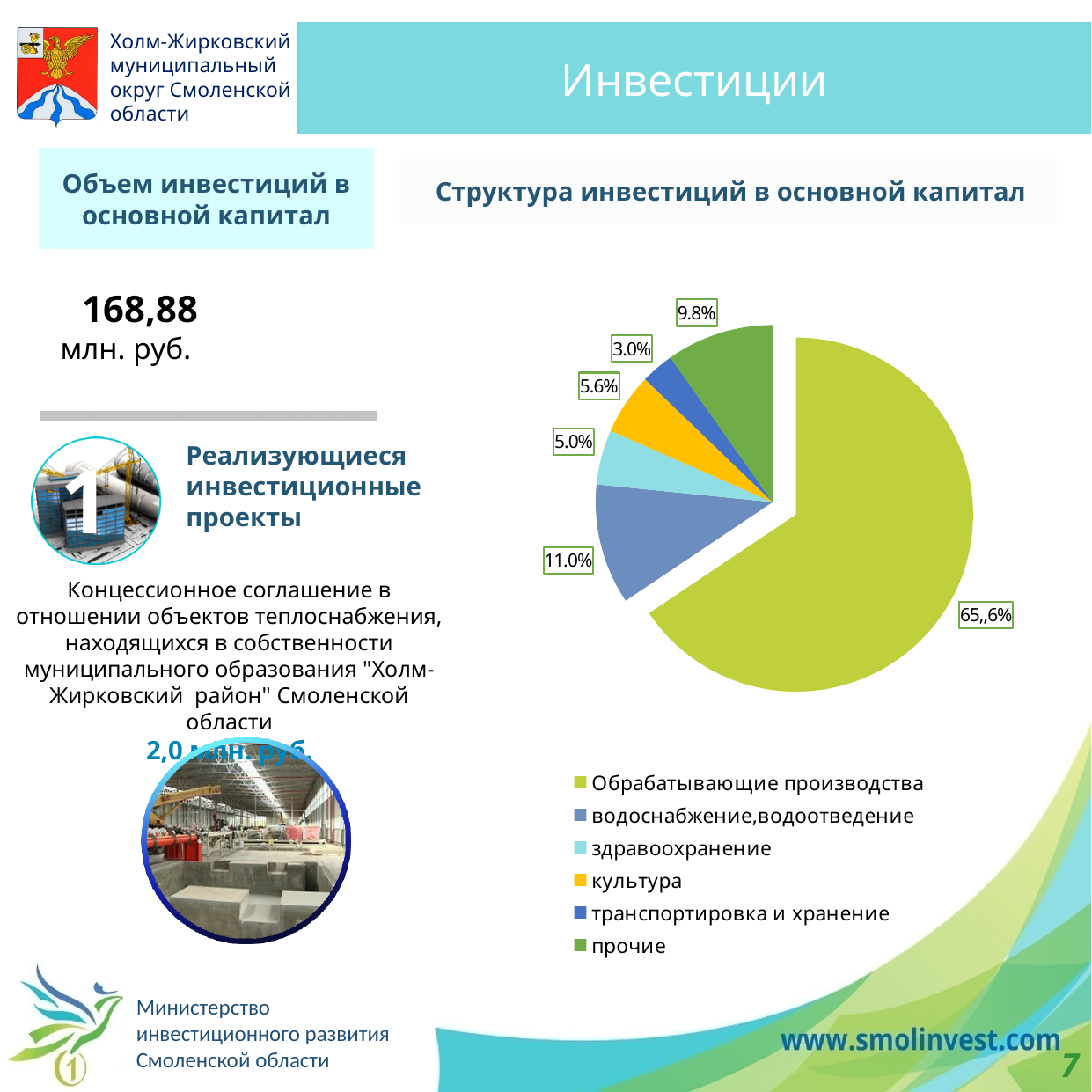
What kind of chart is shown under the heading "Структура инвестиций в основной капитал"? pie chart What share does "культура" have in the pie chart? 5.6% What share does "транспортировка и хранение" have in the pie chart? 3.0% In the pie chart, which has the larger share: "культура" or "здравоохранение"? культура What share does "водоснабжение,водоотведение" have in the pie chart? 11.0% What share does "здравоохранение" have in the pie chart? 5.0% In the pie chart, how much larger is the share of "водоснабжение,водоотведение" than the share of "прочие"? 1.2% Which category has the largest share in the pie chart "Структура инвестиций в основной капитал"? Обрабатывающие производства How many entries does the legend of the pie chart list? 6 How many slices does the pie chart "Структура инвестиций в основной капитал" have? 6 Which category has the smallest share in the pie chart "Структура инвестиций в основной капитал"? транспортировка и хранение What share does "прочие" have in the pie chart? 9.8%